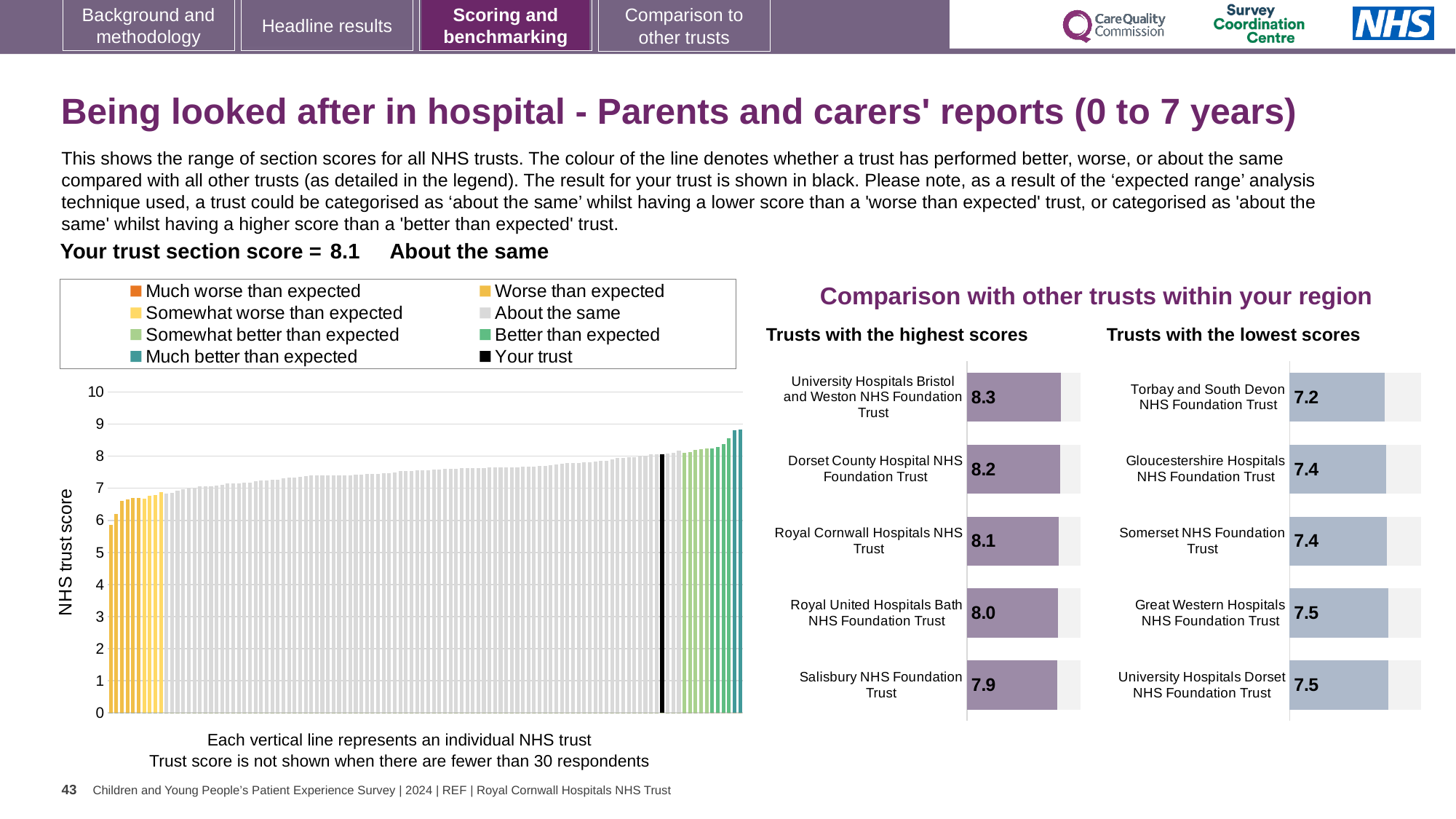
In the NHS trust score chart on the left, is the value of the tallest bar greater or less than 8? greater In the 'Trusts with the highest scores' chart, what is the score for Royal Cornwall Hospitals NHS Trust? 8.1 In the 'Trusts with the highest scores' chart, what is the difference between the scores of University Hospitals Bristol and Weston NHS Foundation Trust and Salisbury NHS Foundation Trust? 0.4 How many entries does the legend of the NHS trust score chart on the left list? 8 In the 'Trusts with the highest scores' chart, which has the higher score: Dorset County Hospital NHS Foundation Trust or Royal United Hospitals Bath NHS Foundation Trust? Dorset County Hospital NHS Foundation Trust In the 'Trusts with the highest scores' chart, what is the score for University Hospitals Bristol and Weston NHS Foundation Trust? 8.3 In the NHS trust score chart on the left, do the values rise or fall from left to right? Rise In the 'Trusts with the lowest scores' chart, which trust has the lowest score? Torbay and South Devon NHS Foundation Trust How many trusts are shown in the 'Trusts with the lowest scores' chart? 5 In the 'Trusts with the lowest scores' chart, what is the score for Torbay and South Devon NHS Foundation Trust? 7.2 What kind of chart is the NHS trust score chart on the left of the slide? Bar chart In the 'Trusts with the highest scores' chart, which trust has the highest score? University Hospitals Bristol and Weston NHS Foundation Trust